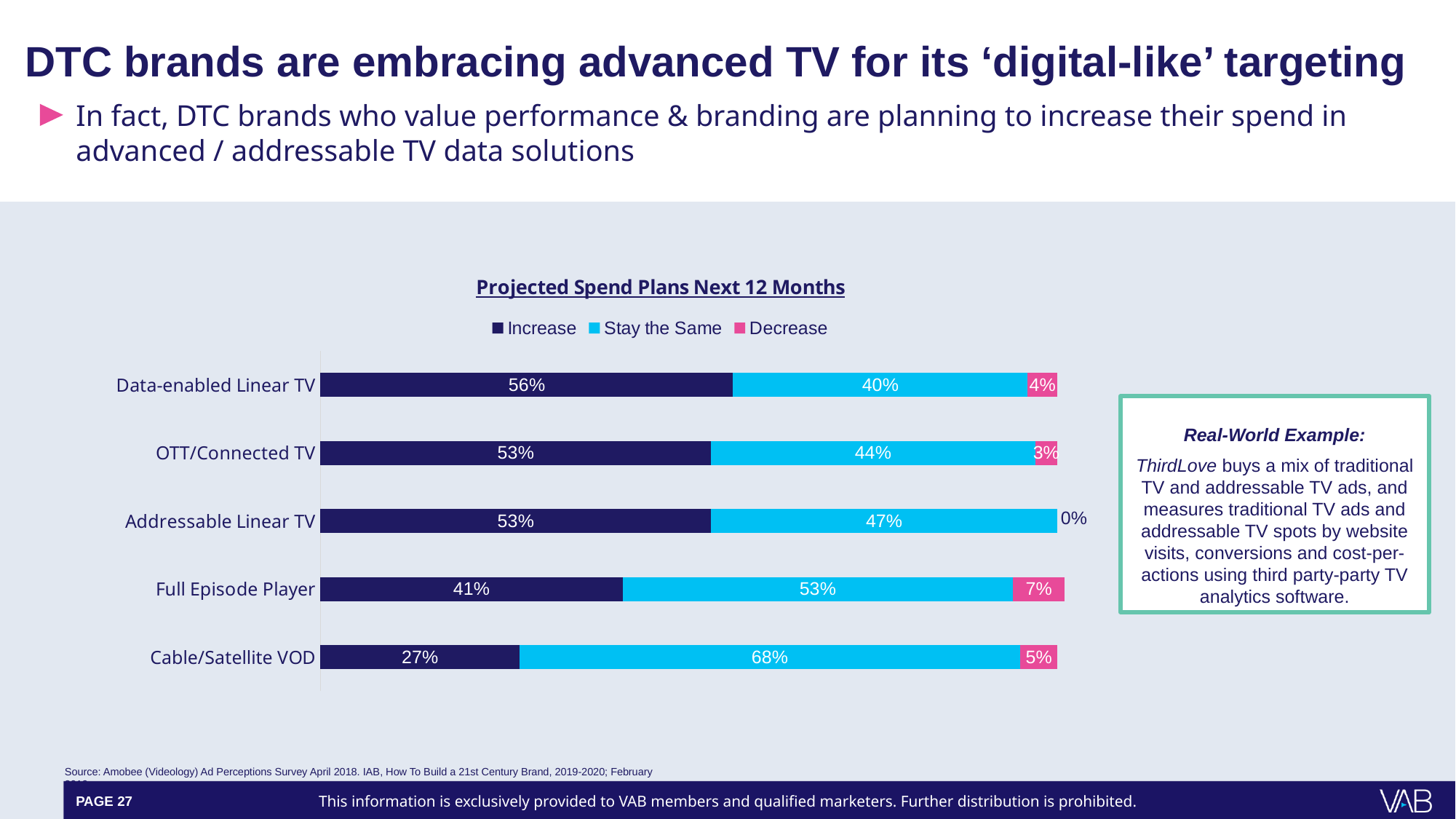
What is the 'Stay the Same' value for Cable/Satellite VOD? 68% What is the title of the chart? Projected Spend Plans Next 12 Months How many categories are shown in the chart? 5 How many series does the legend list? 3 What is the 'Increase' value for Data-enabled Linear TV? 56% What is the difference between the 'Increase' values for Data-enabled Linear TV and Cable/Satellite VOD? 29% Which category has the lowest 'Increase' value? Cable/Satellite VOD Which category has the highest 'Increase' value? Data-enabled Linear TV Which is larger: the 'Stay the Same' value for OTT/Connected TV or for Addressable Linear TV? Addressable Linear TV What kind of chart is shown on the slide? Stacked bar chart What is the 'Decrease' value for Full Episode Player? 7% What is the 'Decrease' value for Addressable Linear TV? 0%